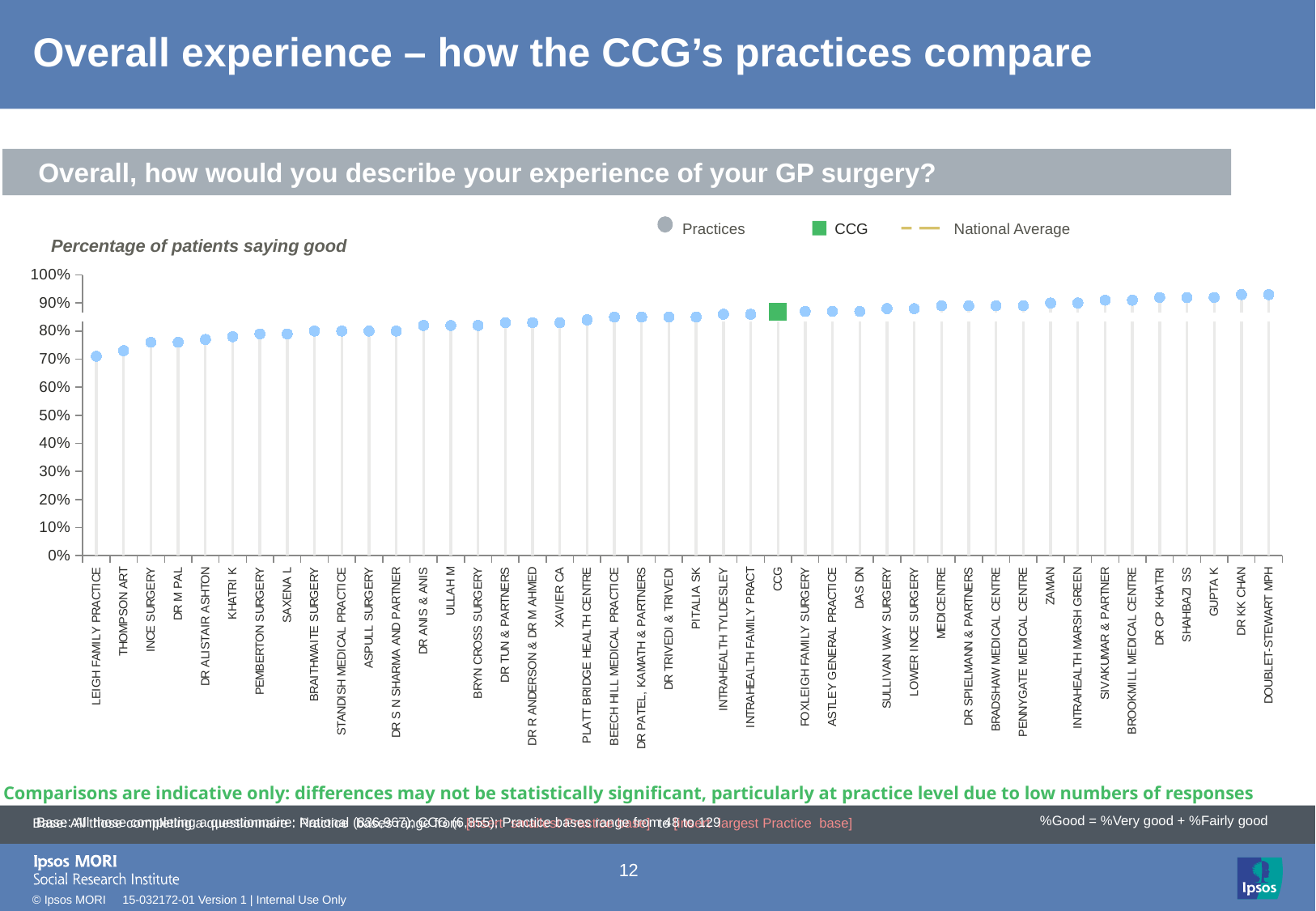
What colour is the CCG marker in the legend? green Is the value for CCG greater or less than 90%? less Is the value for ZAMAN greater or less than 80%? greater Is the value for DOUBLET-STEWART MPH greater or less than 90%? greater Which has a higher percentage of patients saying good, DR KK CHAN or LEIGH FAMILY PRACTICE? DR KK CHAN Do the values rise or fall from left to right along the x axis? rise How many entries does the chart legend list? 3 Which practice has the lowest percentage of patients saying good? LEIGH FAMILY PRACTICE What is the axis title shown above the chart? Percentage of patients saying good